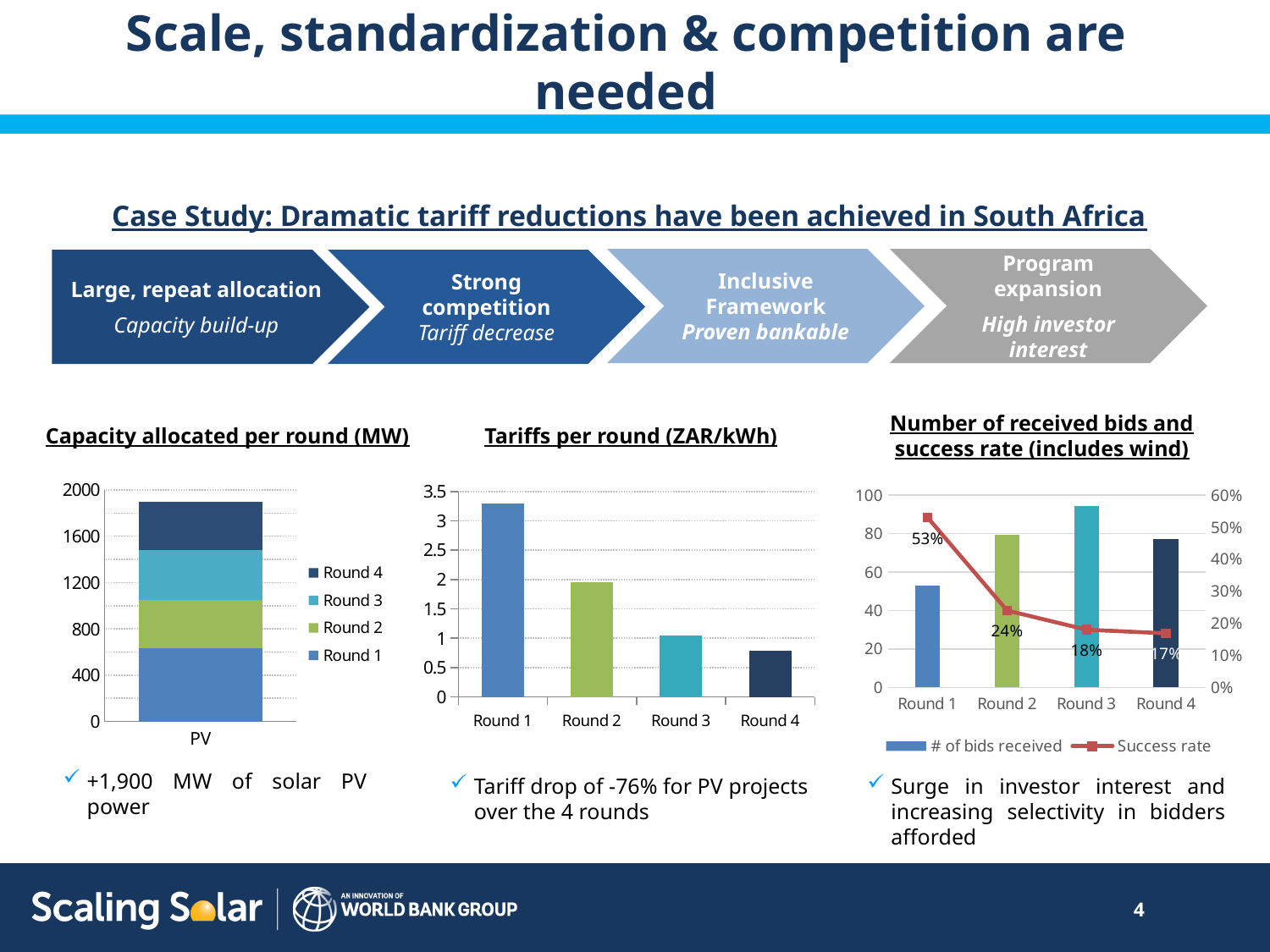
In the 'Tariffs per round (ZAR/kWh)' chart, do the tariffs rise or fall from Round 1 to Round 4? fall In the 'Number of received bids and success rate (includes wind)' chart, what is the success rate for Round 1? 53% In the 'Number of received bids and success rate (includes wind)' chart, how many series does the legend list? 2 In the 'Number of received bids and success rate (includes wind)' chart, which round has the lowest success rate? Round 4 In the 'Number of received bids and success rate (includes wind)' chart, which round received the most bids? Round 3 In the 'Tariffs per round (ZAR/kWh)' chart, is the value for Round 1 greater or less than 3? greater In the 'Number of received bids and success rate (includes wind)' chart, by how many percentage points does the Round 1 success rate exceed the Round 4 success rate? 36 percentage points What kind of chart is 'Tariffs per round (ZAR/kWh)'? bar chart In the 'Capacity allocated per round (MW)' chart, how many rounds does the legend list? 4 In the 'Number of received bids and success rate (includes wind)' chart, what is the success rate for Round 3? 18% In the 'Number of received bids and success rate (includes wind)' chart, is the number of bids received in Round 2 greater or less than 60? greater In the 'Capacity allocated per round (MW)' chart, is the total height of the PV stacked bar greater or less than 1600? greater